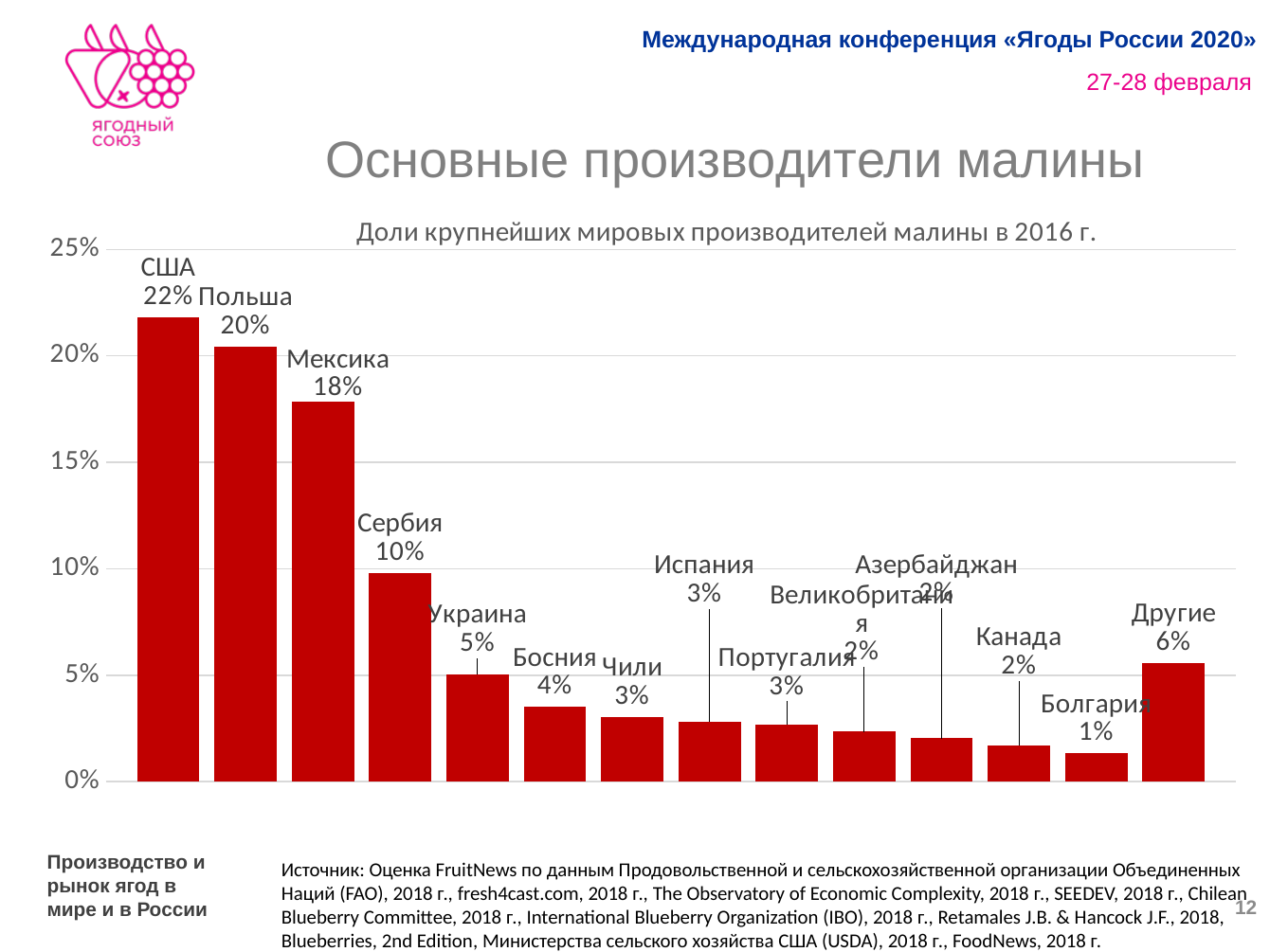
What is the difference between the values for США and Польша? 2% What share does Мексика have in the chart? 18% What is the value shown for Сербия? 10% What is the value for Болгария? 1% Is the value for Мексика greater or less than 15%? greater Which country has the highest share in the chart? США Which category has the lowest value in the chart? Болгария How many bars are shown in the chart? 14 Which is larger, the value for Украина or the value for Другие? Другие What is the value for США in the chart 'Доли крупнейших мировых производителей малины в 2016 г.'? 22% What type of chart is shown on the slide? Bar chart What is the title of the chart? Доли крупнейших мировых производителей малины в 2016 г.